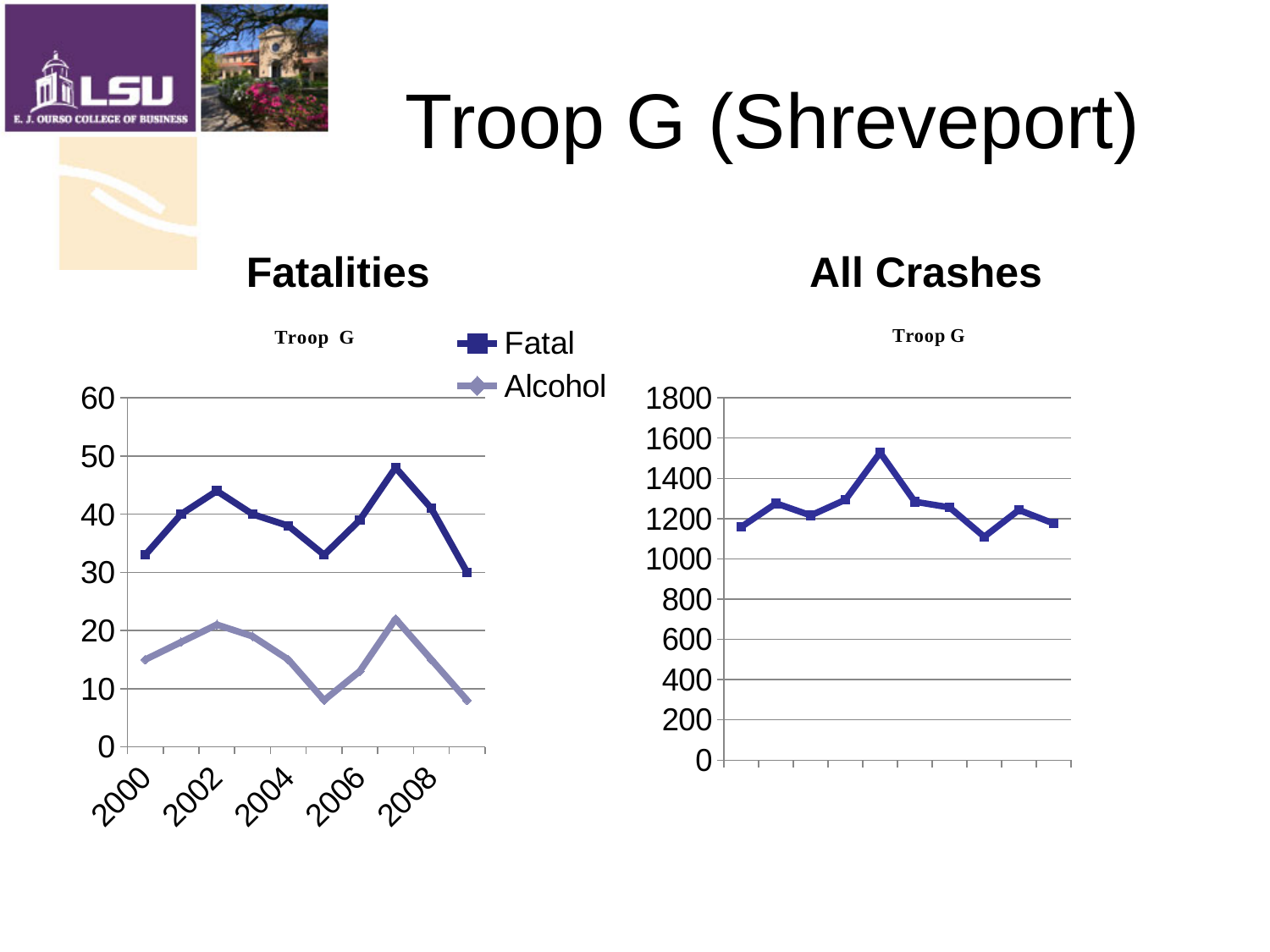
On the Fatalities chart, is the Fatal value for 2007 greater or less than 40? greater On the Fatalities chart, what kind of chart is used? line chart On the Fatalities chart, is the Fatal value for 2009 greater or less than 40? less On the Fatalities chart, which series is higher in 2000, Fatal or Alcohol? Fatal On the All Crashes chart, is the highest point greater or less than 1400? greater On the All Crashes chart, what kind of chart is used? line chart On the Fatalities chart, what are the two series named in the legend? Fatal and Alcohol On the Fatalities chart, in which year is the Fatal series at its highest? 2007 On the Fatalities chart, how many series does the legend list? 2 On the All Crashes chart, how many data points are plotted? 10